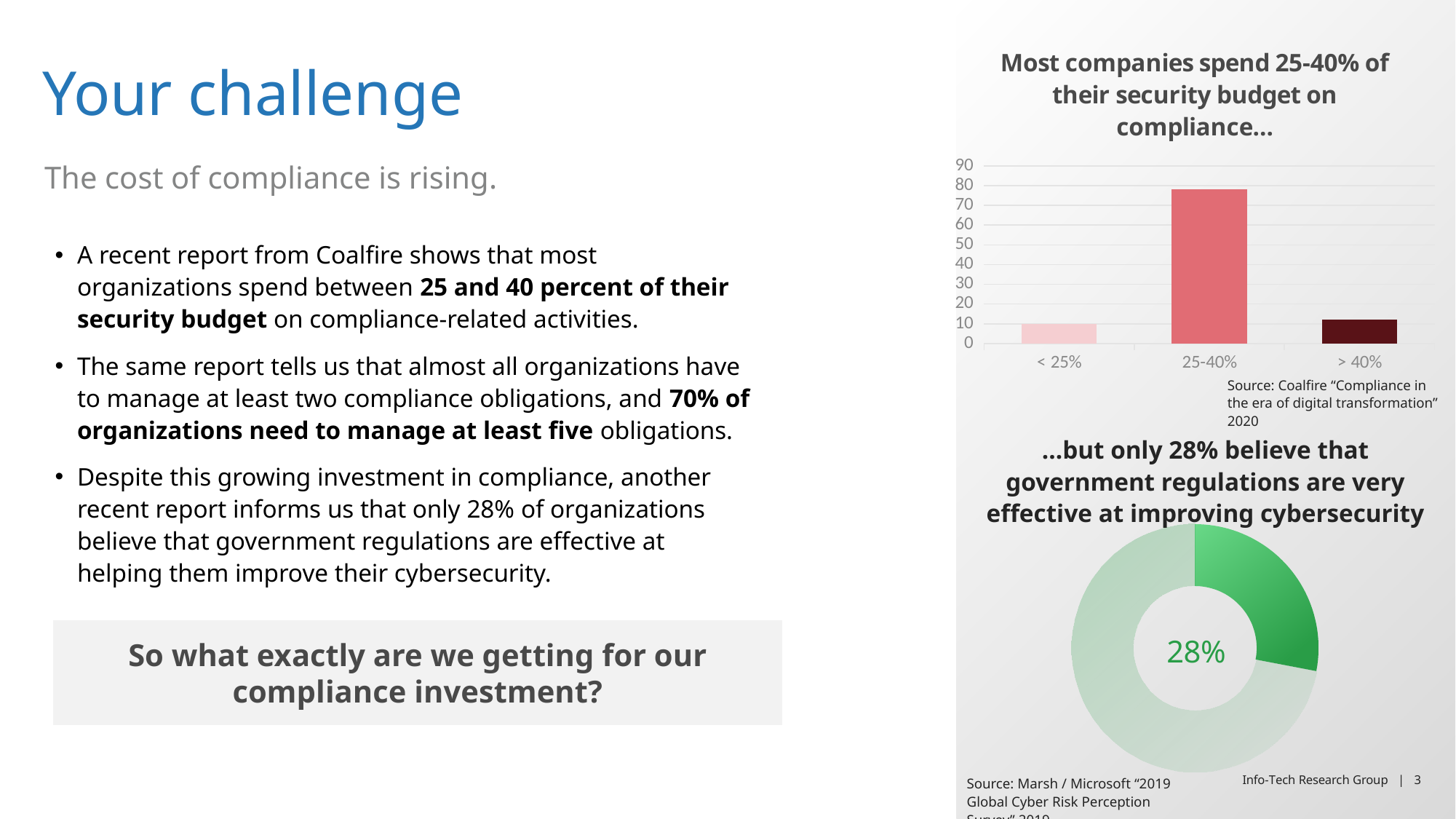
In the bar chart titled "Most companies spend 25-40% of their security budget on compliance...", which category has the highest bar? 25-40% In the bar chart titled "Most companies spend 25-40% of their security budget on compliance...", which is larger, the value for 25-40% or the value for > 40%? 25-40% In the pie chart titled "...but only 28% believe that government regulations are very effective at improving cybersecurity", is the highlighted slice greater or less than half of the pie? less In the bar chart titled "Most companies spend 25-40% of their security budget on compliance...", how many categories are shown on the x axis? 3 In the bar chart titled "Most companies spend 25-40% of their security budget on compliance...", is the value for 25-40% greater or less than 50? greater What source is cited below the bar chart titled "Most companies spend 25-40% of their security budget on compliance..."? Coalfire "Compliance in the era of digital transformation" 2020 In the bar chart titled "Most companies spend 25-40% of their security budget on compliance...", is the value for > 40% greater or less than 20? less What kind of chart is the top-right chart titled "Most companies spend 25-40% of their security budget on compliance..."? bar chart In the bar chart titled "Most companies spend 25-40% of their security budget on compliance...", what is the highest value shown on the y axis? 90 What kind of chart is the bottom-right chart titled "...but only 28% believe that government regulations are very effective at improving cybersecurity"? doughnut chart In the bar chart titled "Most companies spend 25-40% of their security budget on compliance...", is the value for < 25% greater or less than 30? less In the pie chart titled "...but only 28% believe that government regulations are very effective at improving cybersecurity", what share is shown by the highlighted green slice? 28%